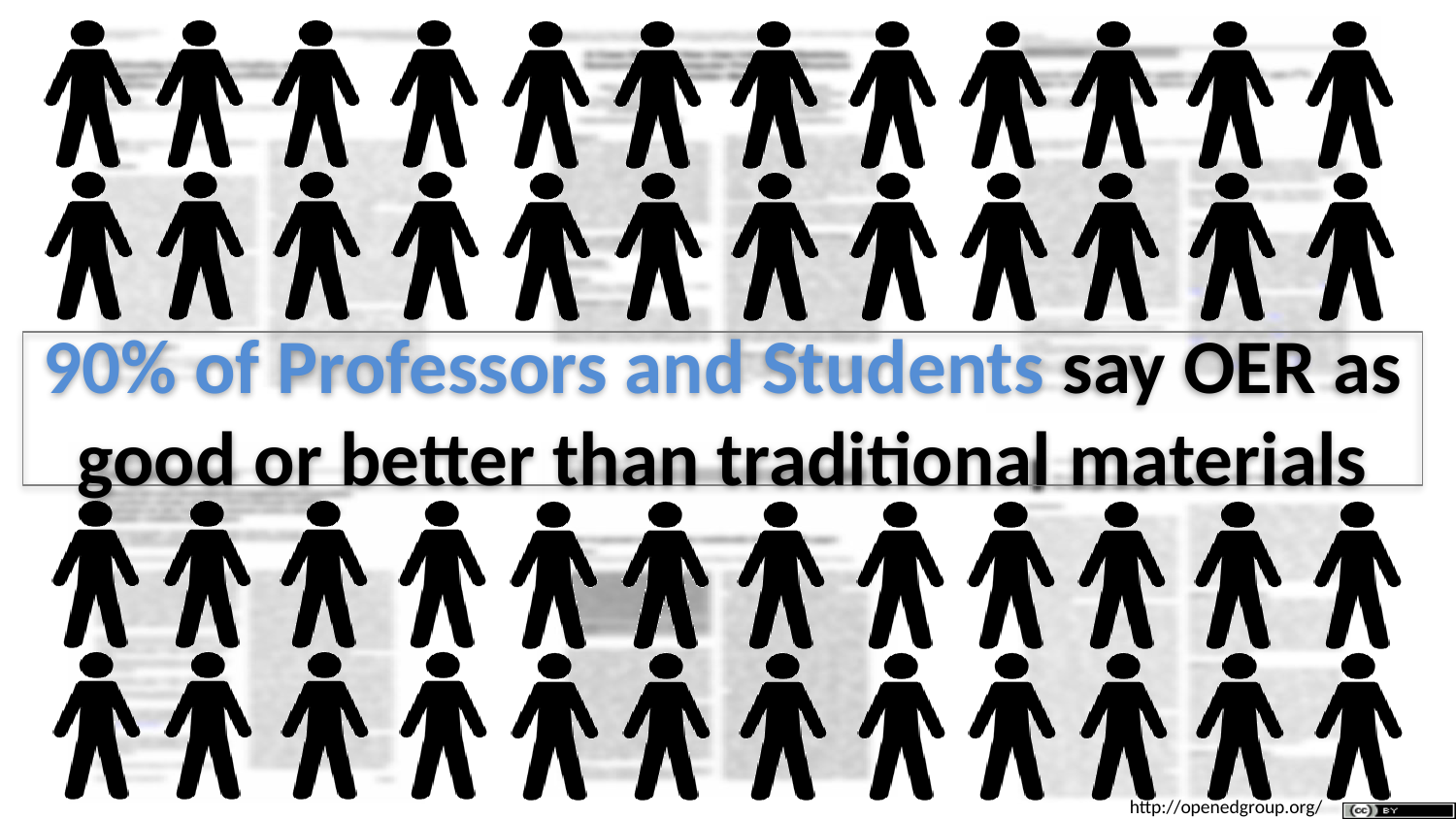
How many rows of person icons are shown on the slide? 4 What percentage of professors and students say OER is as good or better than traditional materials, according to the slide? 90% Is the percentage stated on the slide greater or less than 50%? greater How many person icons are shown on the slide? 48 What colour are the person icons on the slide? Black